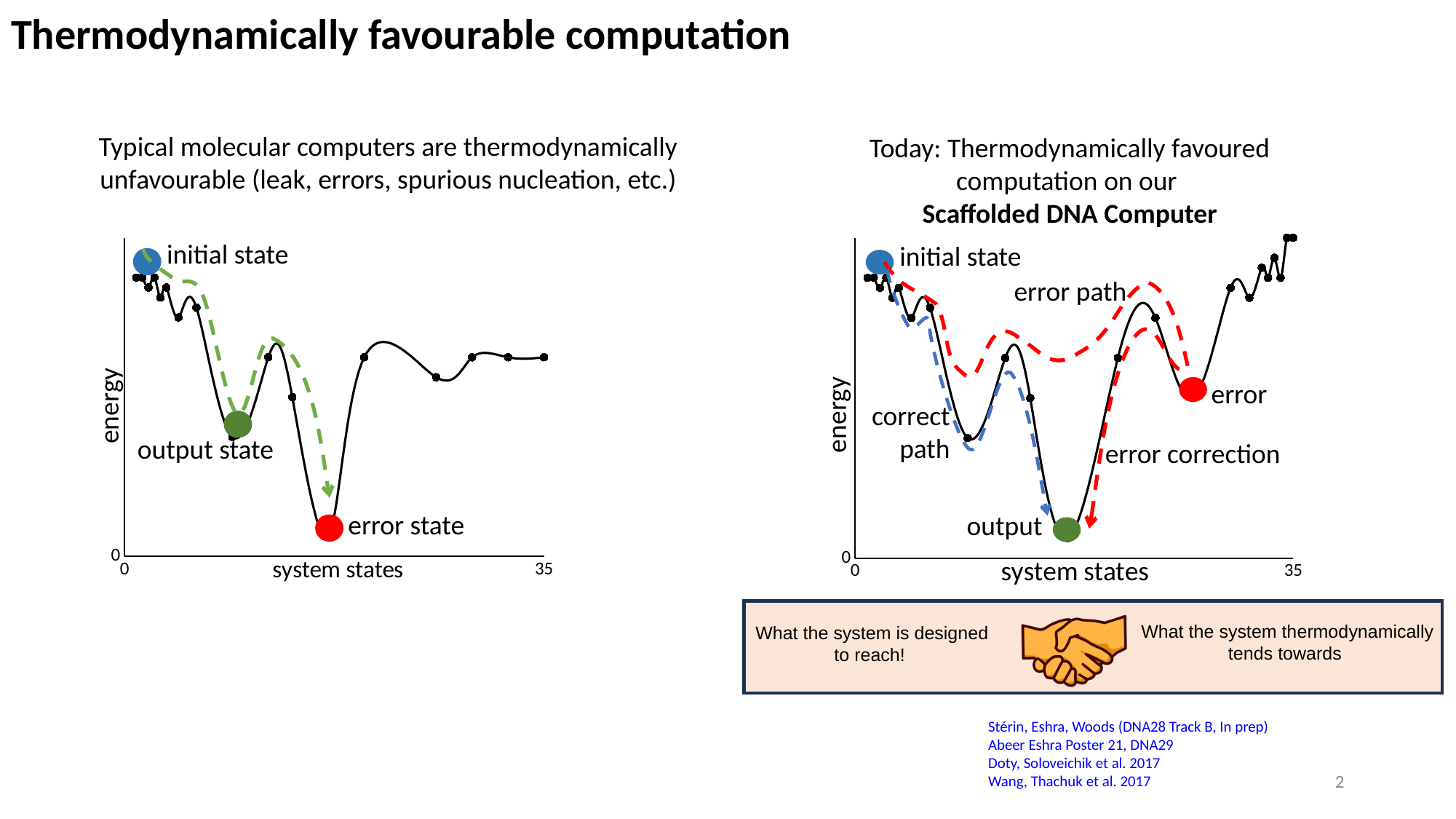
On the right chart, does the energy rise or fall along the correct path from the initial state to the output? fall On the right chart, which has higher energy, the error state or the output state? error On the left chart, which labelled state has the lowest energy? error state On the left chart, what kind of chart is shown? line chart On the left chart, what is the label of the y axis? energy On the left chart, which labelled state has the highest energy? initial state On the right chart, does the energy rise or fall along the error correction path from the error state to the output? fall On the right chart, which labelled state has the highest energy? initial state On the left chart, which has higher energy, the output state or the error state? output state On the right chart, what is the label of the x axis? system states On the left chart, what is the largest value shown on the x axis? 35 On the right chart, which labelled state has the lowest energy? output